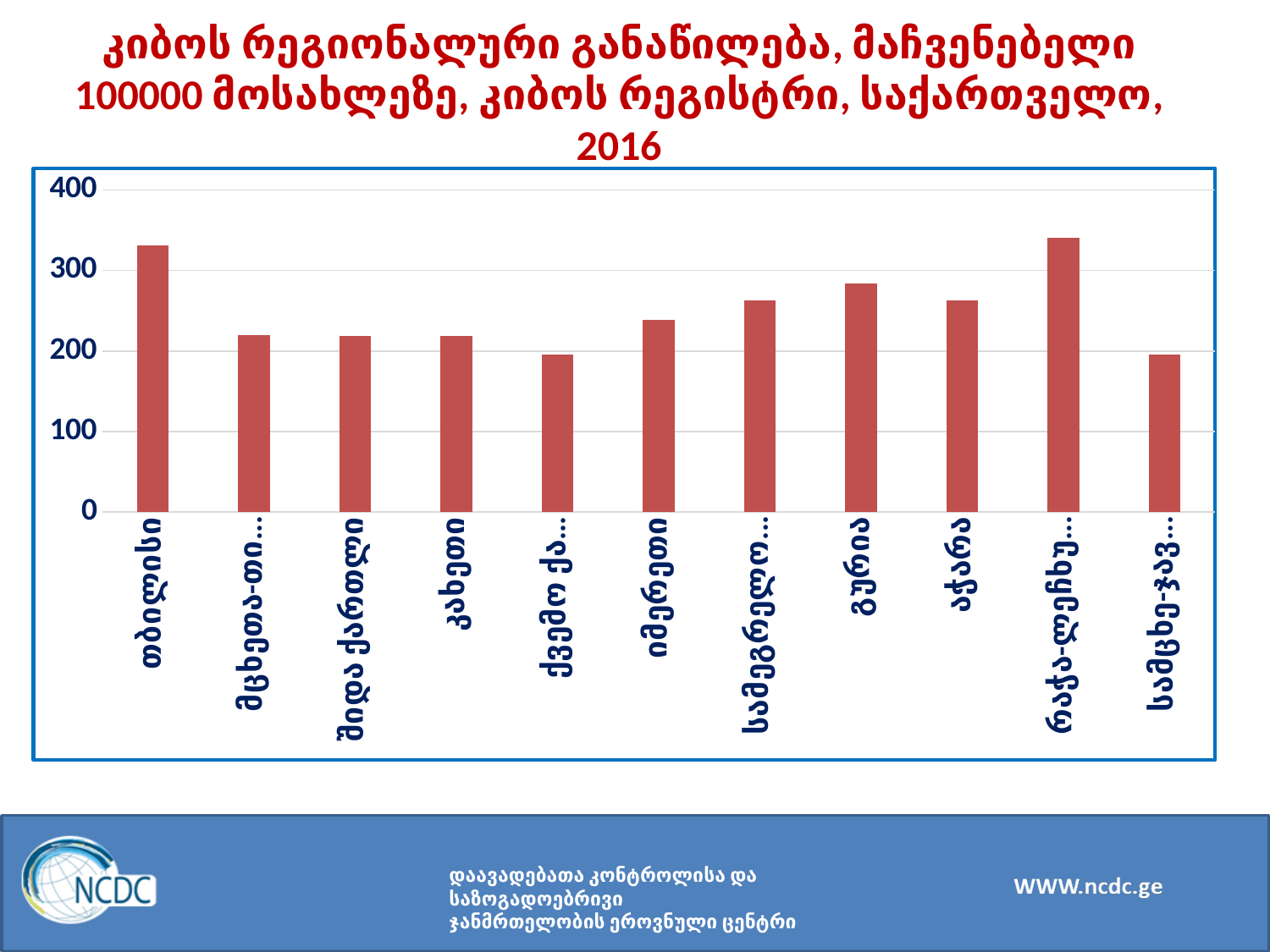
Is the value for იმერეთი greater or less than 200? greater What kind of chart is shown on the slide? bar chart How many regions (bars) are plotted in the chart? 11 Which has the larger value, აჭარა or კახეთი? აჭარა Which year does the chart title say the data refers to? 2016 Is the value for აჭარა greater or less than 200? greater Which has the larger value, გურია or იმერეთი? გურია Is the value for გურია greater or less than 300? less What colour are the bars in the chart? red Which has the larger value, თბილისი or გურია? თბილისი